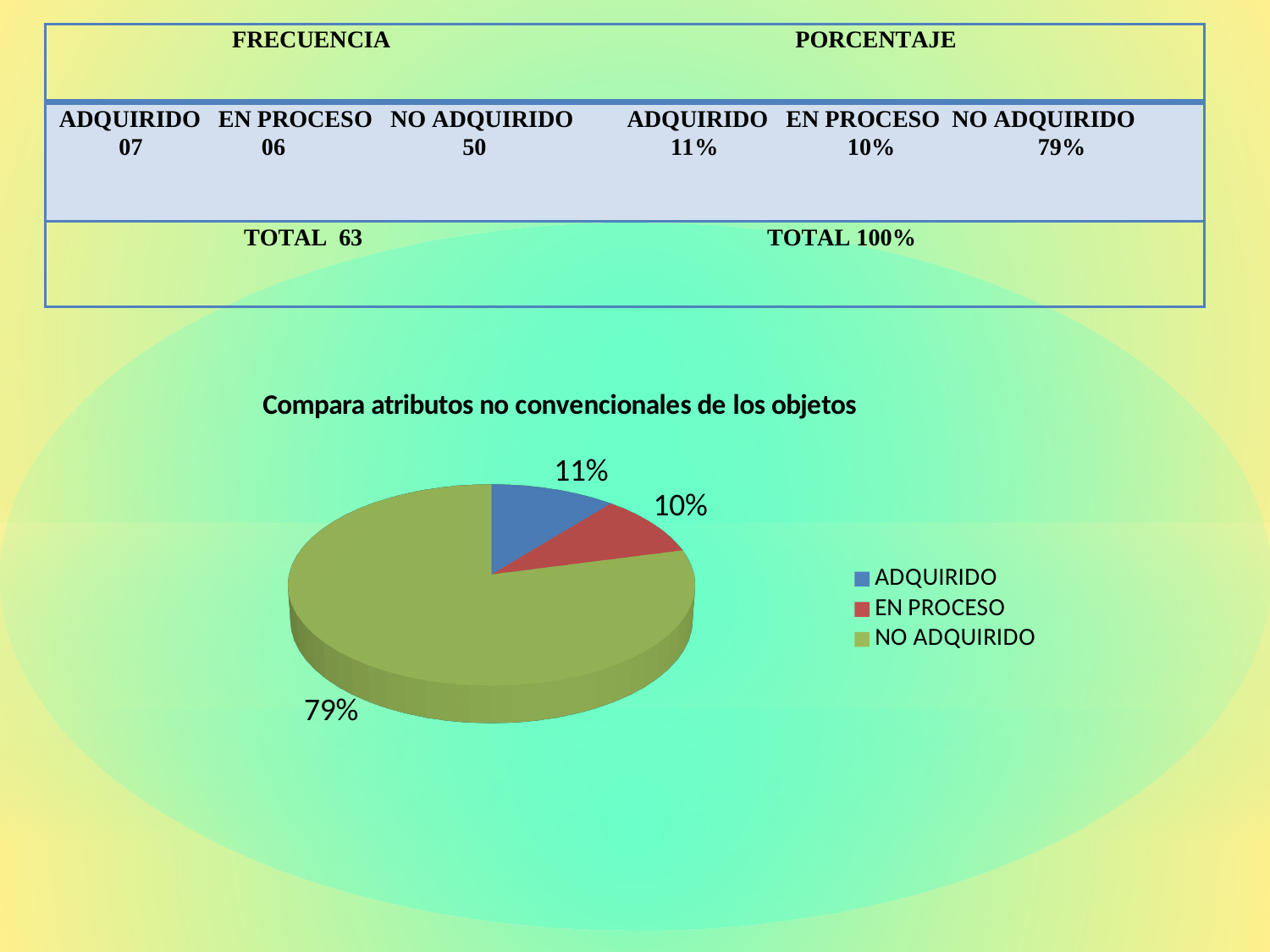
What percentage does the ADQUIRIDO slice show? 11% Which category has the largest slice of the pie? NO ADQUIRIDO Which category has the smallest slice of the pie? EN PROCESO Which colour represents EN PROCESO in the legend? red What is the chart's title? Compara atributos no convencionales de los objetos What is the difference in percentage points between the NO ADQUIRIDO slice and the ADQUIRIDO slice? 68% Is the NO ADQUIRIDO slice larger or smaller than the ADQUIRIDO slice? larger What kind of chart is shown on the slide? pie chart What percentage does the NO ADQUIRIDO slice show? 79% How many slices does the pie chart have? 3 How many categories does the legend list? 3 What percentage does the EN PROCESO slice show? 10%